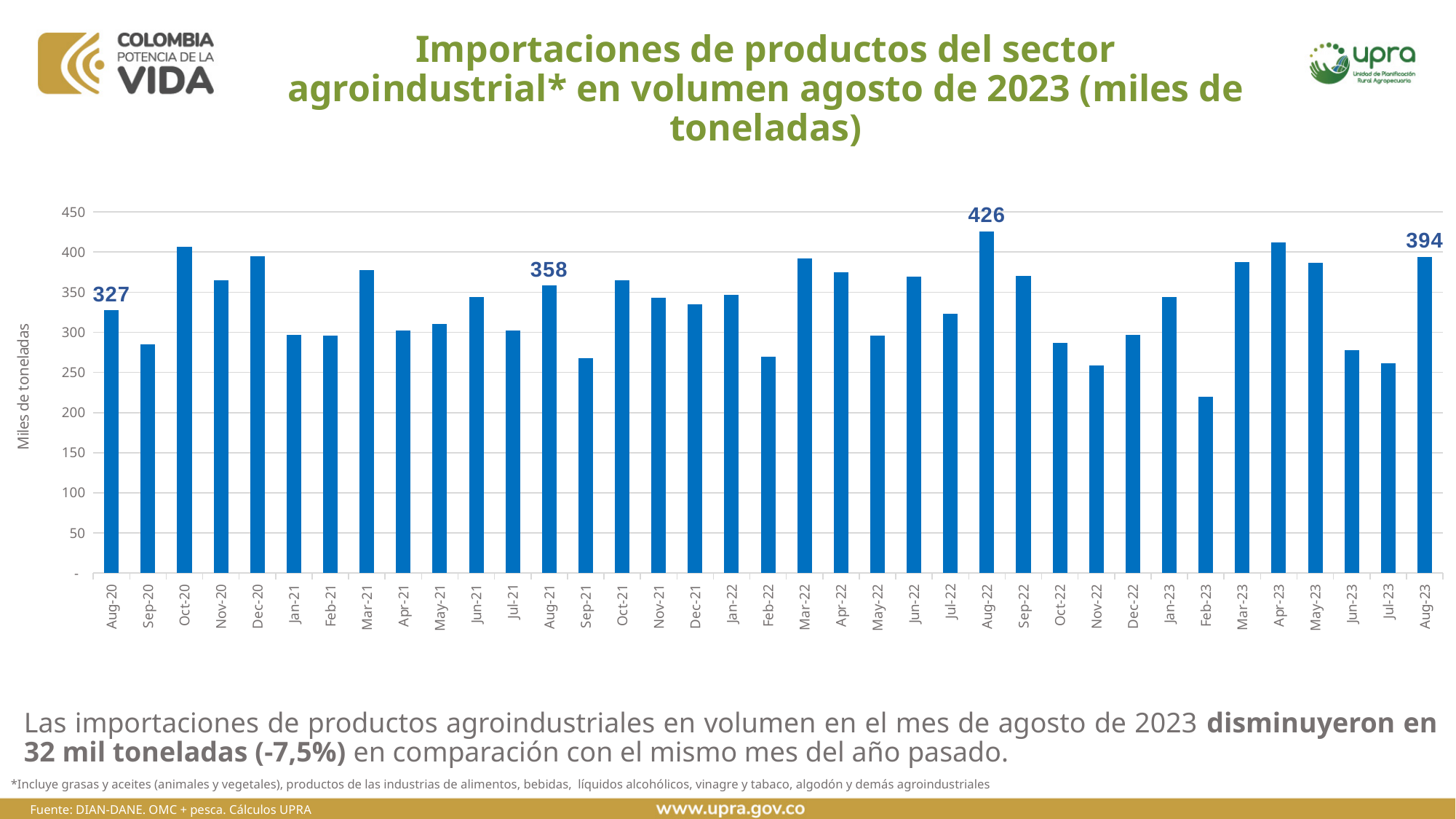
What is the difference between the values for Aug-22 and Aug-23? 32 Which is larger, the value for Aug-21 or the value for Aug-23? Aug-23 What is the value for Aug-23? 394 What is the value for Aug-22? 426 Is the value for Feb-23 greater or less than 250? less What is the value for Aug-21? 358 Which month has the lowest value? Feb-23 What is the value for Aug-20? 327 What kind of chart is shown on the slide? Bar chart Is the value for Oct-20 greater or less than 400? greater How many months are plotted on the chart? 37 Which month has the highest value? Aug-22